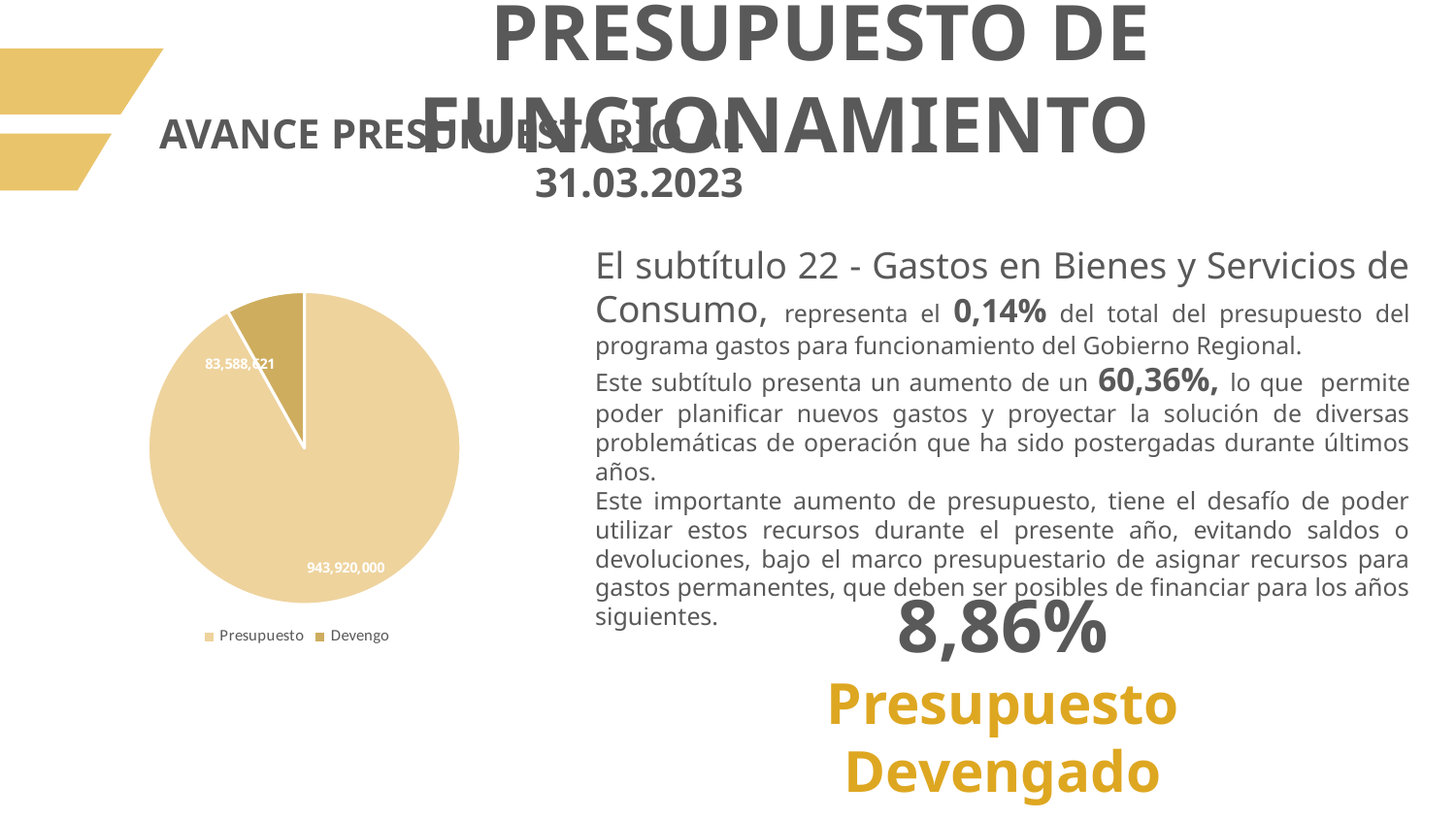
Which slice of the pie chart is drawn in the darker gold colour? Devengo How many slices does the pie chart have? 2 Which slice of the pie chart is the smallest? Devengo What is the difference between the Presupuesto value and the Devengo value in the pie chart? 860,331,379 What is the total of the two values shown in the pie chart? 1,027,508,621 Which slice of the pie chart is the largest? Presupuesto What is the value shown for Devengo in the pie chart? 83,588,621 Which is larger in the pie chart, Presupuesto or Devengo? Presupuesto How many entries does the legend of the pie chart list? 2 What is the value shown for Presupuesto in the pie chart? 943,920,000 What are the two legend entries of the pie chart? Presupuesto and Devengo What kind of chart is shown on the slide? Pie chart